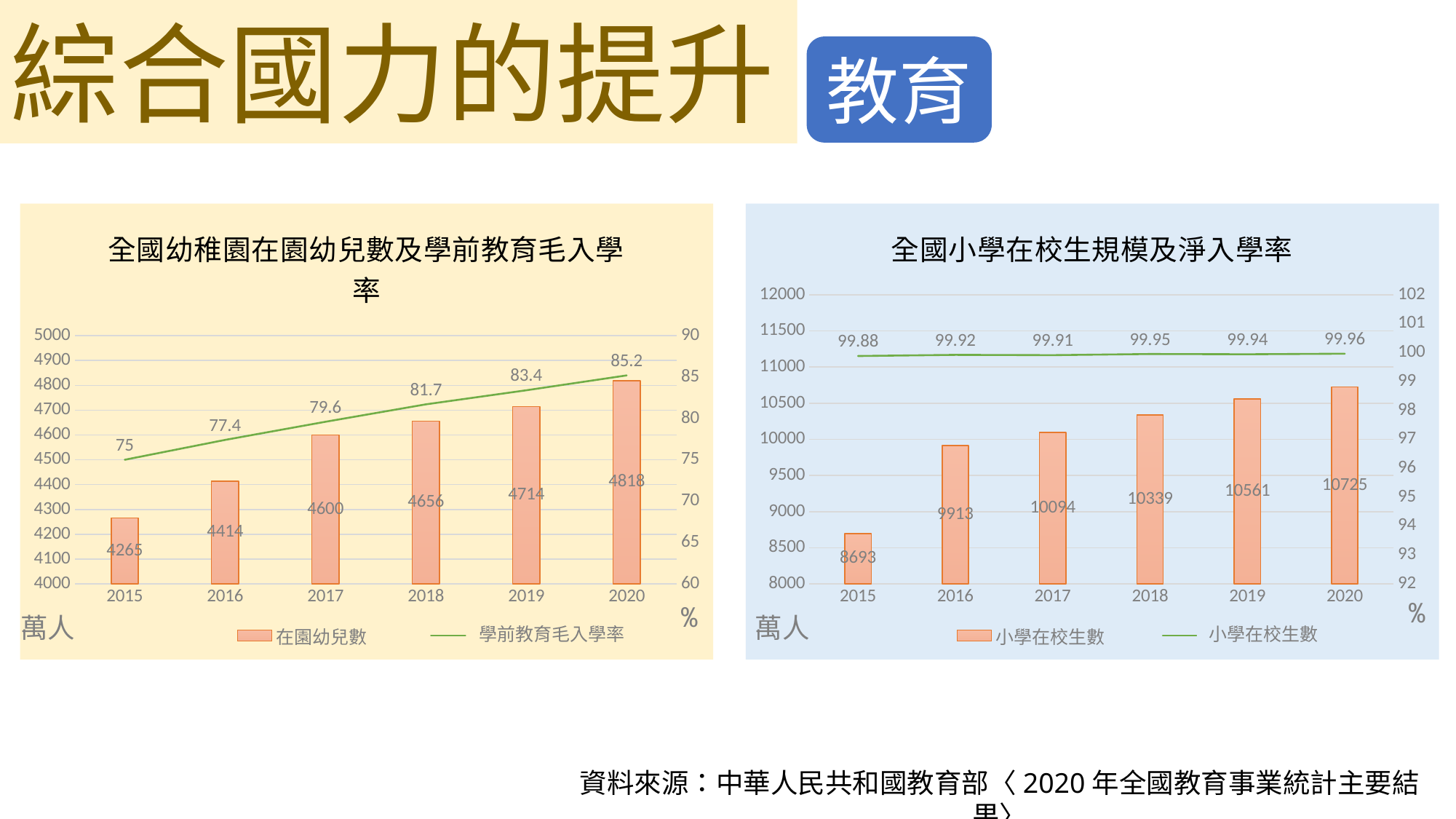
In the right chart (全國小學在校生規模及淨入學率), is the 小學在校生數 for 2017 greater or less than 10000? greater How many series does the legend of the left chart (全國幼稚園在園幼兒數及學前教育毛入學率) list? 2 In the right chart (全國小學在校生規模及淨入學率), what is the difference in 小學在校生數 between 2016 and 2015? 1220 In the left chart (全國幼稚園在園幼兒數及學前教育毛入學率), by how much did 在園幼兒數 increase from 2015 to 2020? 553 In the left chart (全國幼稚園在園幼兒數及學前教育毛入學率), does the 學前教育毛入學率 rise or fall from 2015 to 2020? rise In the left chart (全國幼稚園在園幼兒數及學前教育毛入學率), which year has the highest 在園幼兒數? 2020 In the left chart (全國幼稚園在園幼兒數及學前教育毛入學率), what is the value of 在園幼兒數 for 2017? 4600 In the right chart (全國小學在校生規模及淨入學率), how many years are shown on the x axis? 6 In the right chart (全國小學在校生規模及淨入學率), which year has the lowest 小學在校生數? 2015 In the left chart (全國幼稚園在園幼兒數及學前教育毛入學率), what is the 學前教育毛入學率 for 2019? 83.4 In the right chart (全國小學在校生規模及淨入學率), what is the net enrolment rate shown for 2015? 99.88 In the right chart (全國小學在校生規模及淨入學率), what is the 小學在校生數 for 2018? 10339